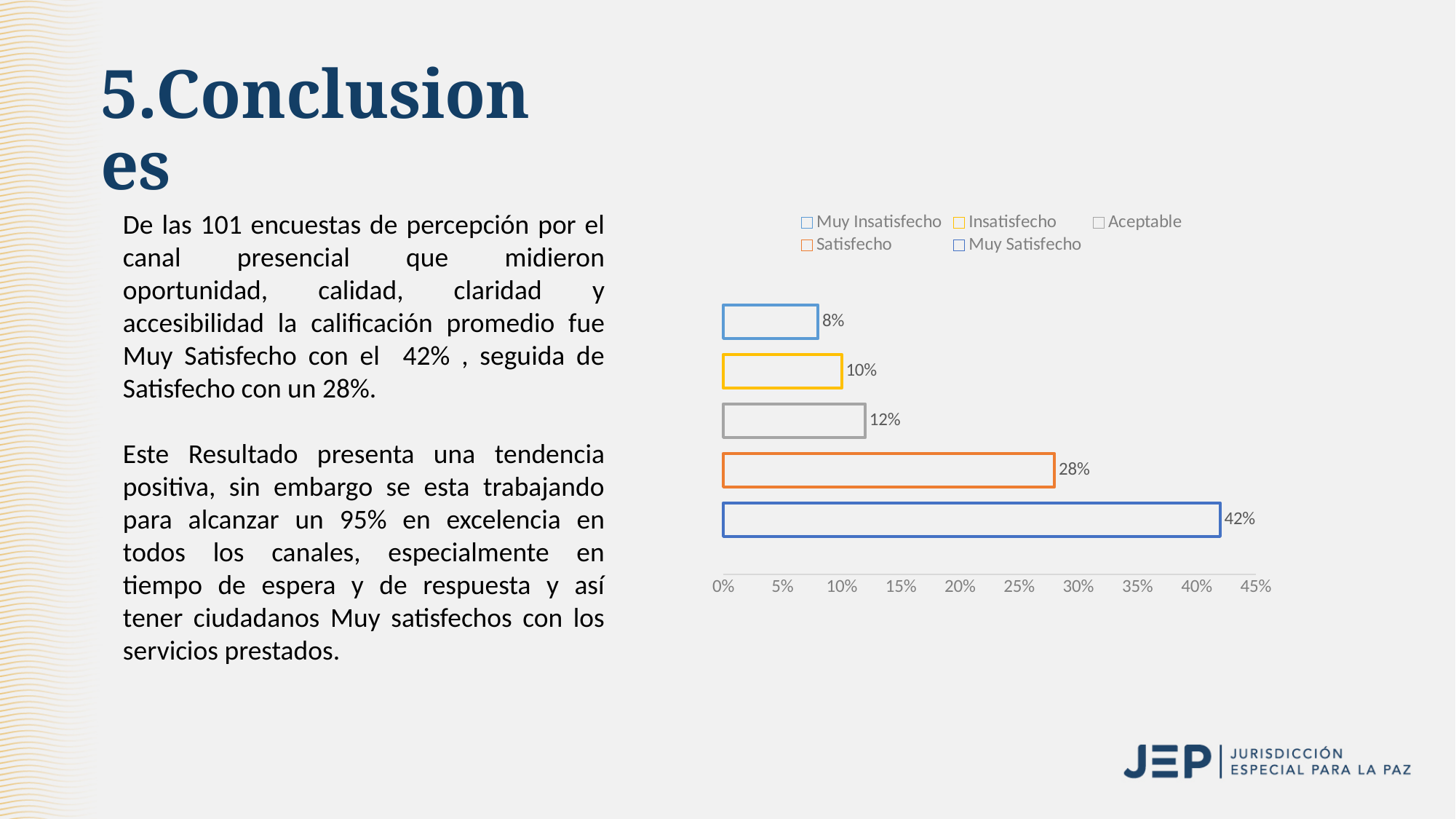
What value is shown for Satisfecho? 28% What value is shown for Aceptable? 12% Which is larger, the value for Aceptable or the value for Insatisfecho? Aceptable What value is shown for Insatisfecho? 10% What value is shown for Muy Insatisfecho? 8% What kind of chart is shown on the slide? Bar chart How many entries does the legend list? 5 What value is shown for Muy Satisfecho? 42% How many bars are plotted in the chart? 5 Which category has the lowest value? Muy Insatisfecho What is the difference between the values for Muy Satisfecho and Satisfecho? 14% Which category has the highest value? Muy Satisfecho